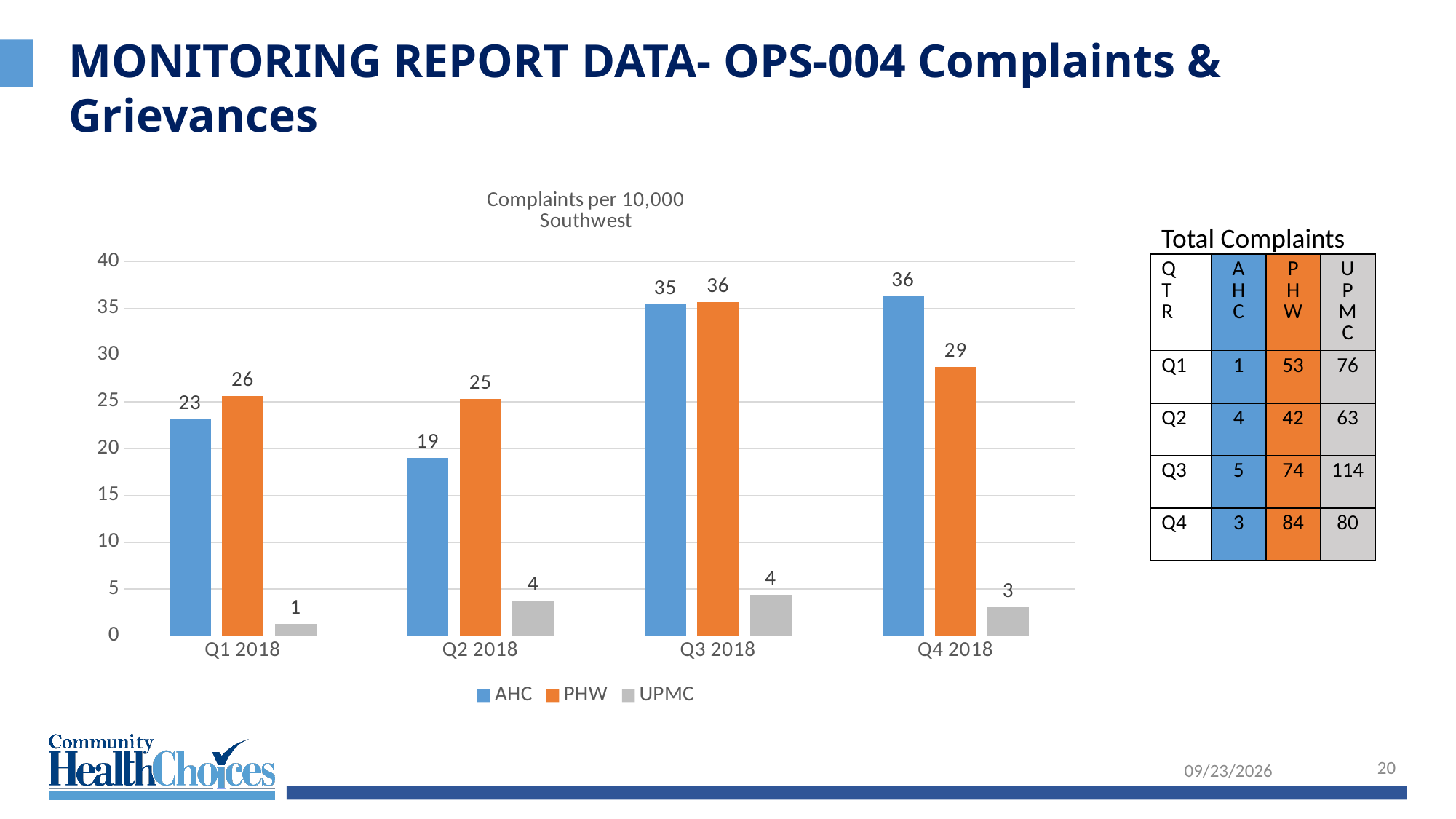
What kind of chart is shown? Bar chart What is the value for PHW in Q1 2018? 26 Is the value for AHC in Q3 2018 greater or less than 30? greater What is the value for UPMC in Q3 2018? 4 What is the value for AHC in Q2 2018? 19 What is the title of the chart? Complaints per 10,000 Southwest Which quarter has the lowest value for UPMC? Q1 2018 Which is larger in Q4 2018, AHC or PHW? AHC How many quarters are shown on the x axis? 4 What is the difference between the PHW value in Q3 2018 and the PHW value in Q4 2018? 7 How many series does the legend list? 3 Which quarter has the highest value for AHC? Q4 2018